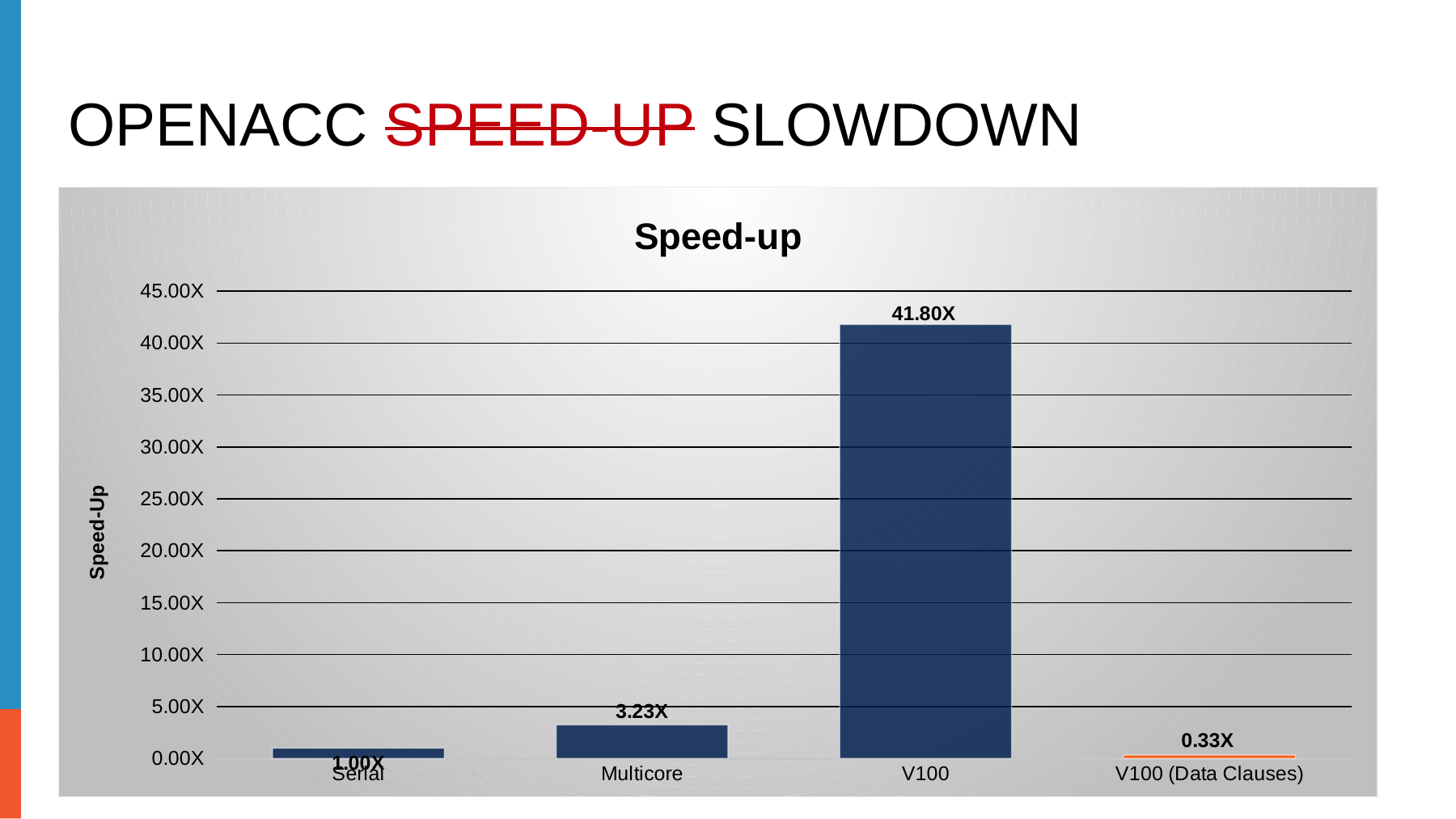
What is the speed-up value for Multicore? 3.23X Which category has the highest speed-up? V100 What is the difference between the speed-up for V100 and Multicore? 38.57X What kind of chart is shown on the slide? Bar chart Is the value for V100 greater or less than 40.00X? greater How many categories are shown on the x axis? 4 What is the speed-up value for Serial? 1.00X What is the speed-up value for V100 (Data Clauses)? 0.33X Which has a larger speed-up, Multicore or Serial? Multicore Which category has the lowest speed-up? V100 (Data Clauses) What is the title of the chart? Speed-up What is the speed-up value for V100? 41.80X